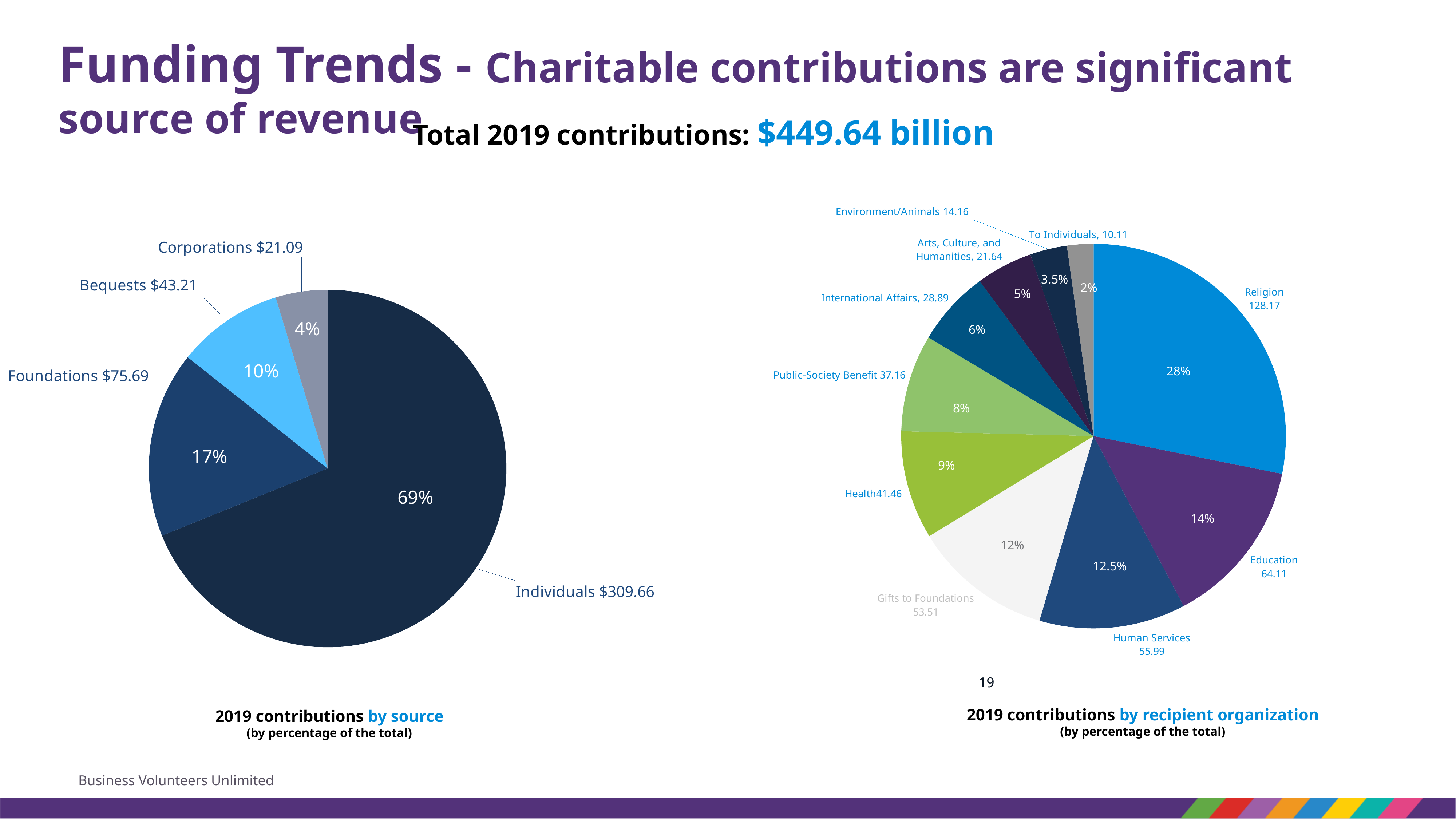
In the '2019 contributions by recipient organization' chart, what percentage of the total goes to Education? 14% In the '2019 contributions by source' chart, what percentage of the total comes from Individuals? 69% In the '2019 contributions by source' chart, what is the difference between the Bequests value and the Corporations value? $22.12 In the '2019 contributions by recipient organization' chart, how many recipient categories are shown? 10 In the '2019 contributions by source' chart, which source has the smallest slice? Corporations In the '2019 contributions by recipient organization' chart, what value is labelled for Human Services? 55.99 In the '2019 contributions by recipient organization' chart, which recipient category has the largest slice? Religion In the '2019 contributions by source' chart, what is the value labelled for Foundations? $75.69 In the '2019 contributions by source' chart, how many sources are shown? 4 What total 2019 contributions figure is stated on the slide? $449.64 billion What kind of chart is the '2019 contributions by recipient organization' chart? Pie chart In the '2019 contributions by recipient organization' chart, which is larger: Health or Public-Society Benefit? Health